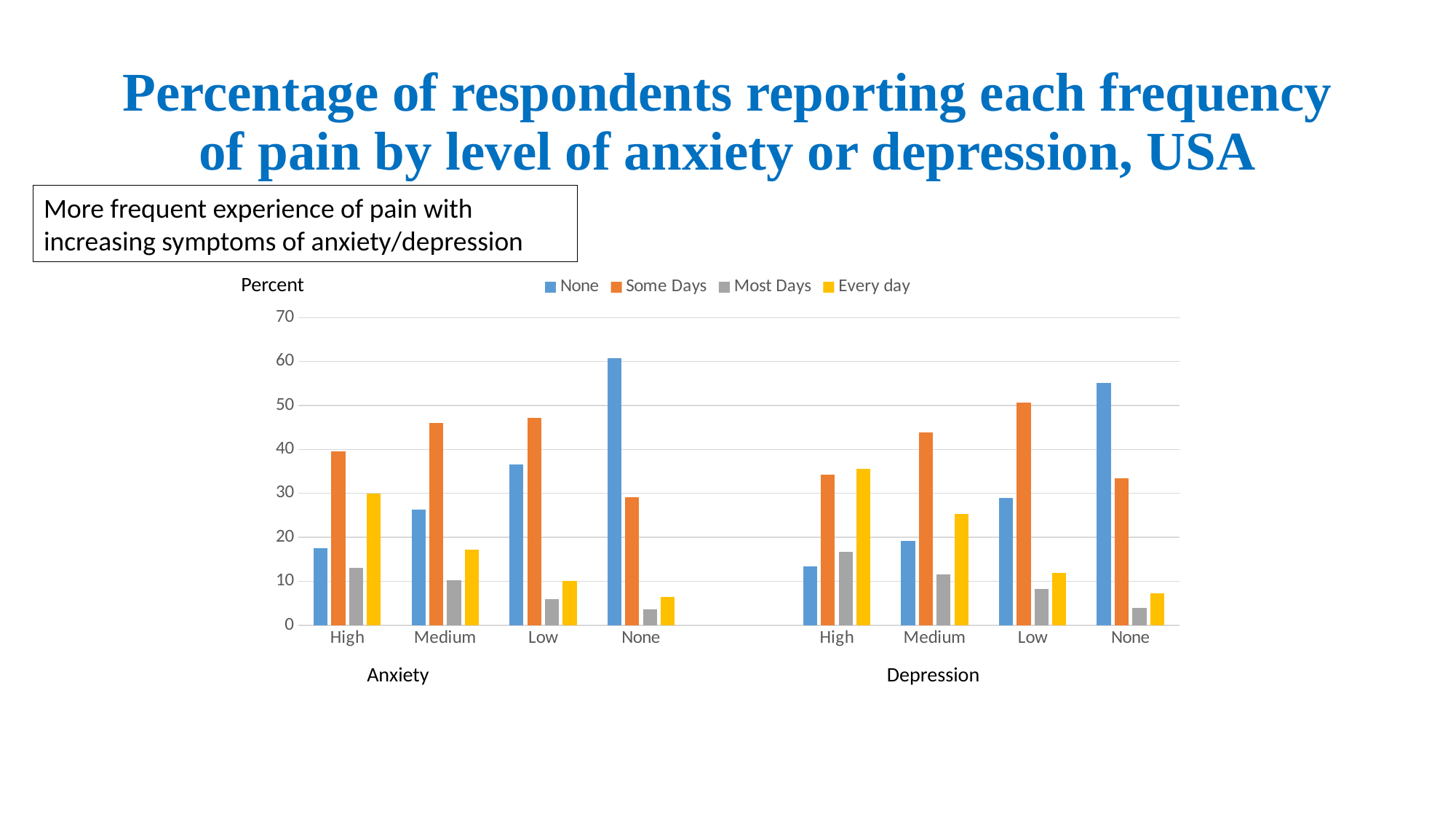
Which category has the lowest None bar? Depression High What label is shown on the vertical axis? Percent Does the None series rise or fall moving from High to None within the Anxiety group? rise How many category groups are shown along the x axis? 8 Is the value of the Some Days series for the Depression Low category greater or less than 40? greater Which is larger: the Every day value for Anxiety High or for Depression High? Depression High How many series does the legend list? 4 Does the Every day series rise or fall moving from High to None within the Anxiety group? fall What kind of chart is shown on the slide? bar chart Which category has the highest None bar? Anxiety None Is the value of the None series for the Anxiety None category greater or less than 50? greater Is the value of the Every day series for the Anxiety High category greater or less than 20? greater